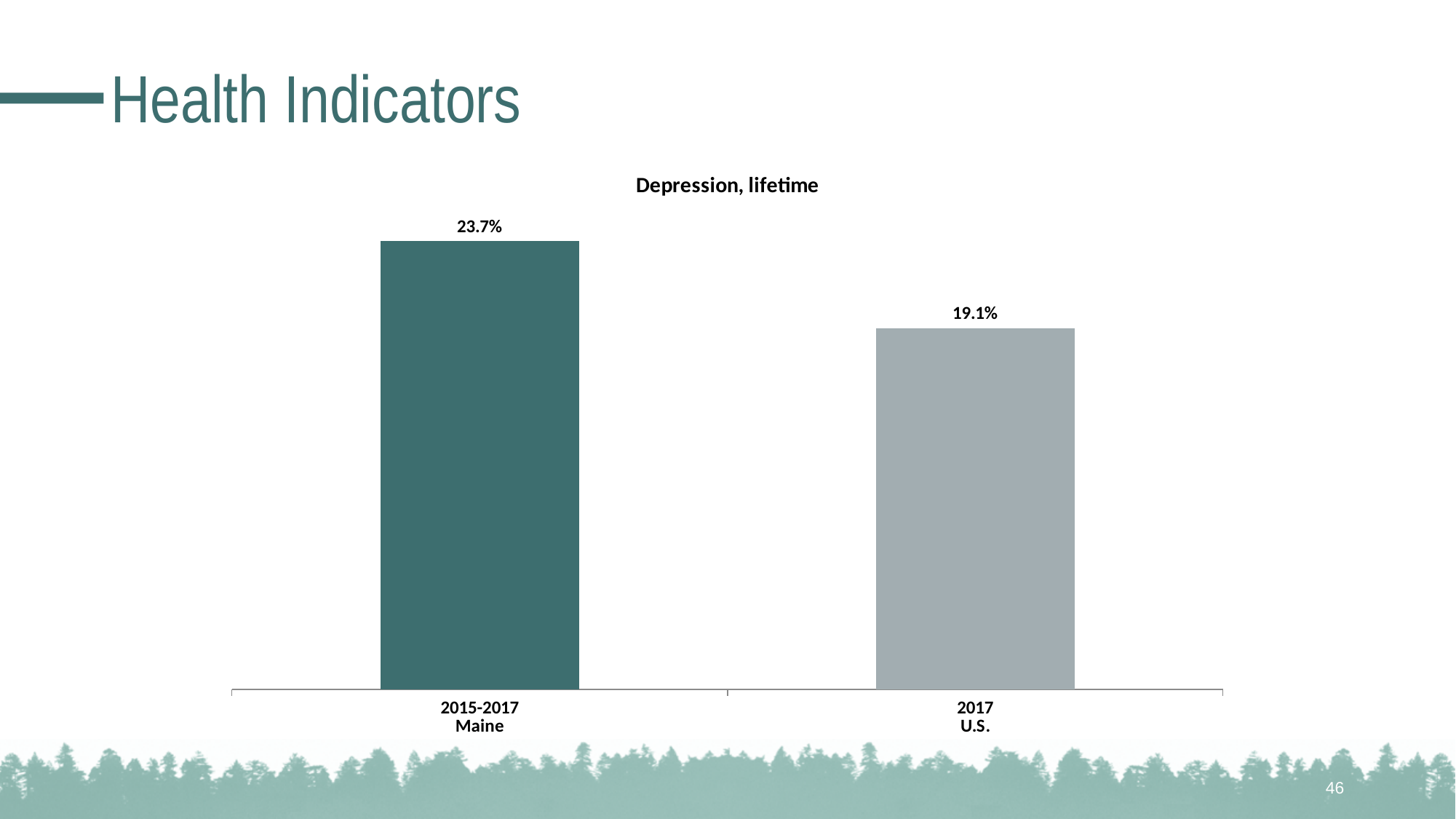
How many bars are shown in the Depression, lifetime chart? 2 What kind of chart is shown on the slide? Bar chart What is the value for 2017 U.S. in the Depression, lifetime chart? 19.1% What colour is the bar for 2015-2017 Maine in the Depression, lifetime chart? Dark teal Do the values fall or rise from the Maine bar to the U.S. bar in the Depression, lifetime chart? Fall What is the difference between the Maine value and the U.S. value in the Depression, lifetime chart? 4.6% Which is larger in the Depression, lifetime chart: the value for 2015-2017 Maine or the value for 2017 U.S.? 2015-2017 Maine Which category has the lowest value in the Depression, lifetime chart? 2017 U.S. What is the value for 2015-2017 Maine in the Depression, lifetime chart? 23.7% Which category has the highest value in the Depression, lifetime chart? 2015-2017 Maine What is the title of the chart on the slide? Depression, lifetime